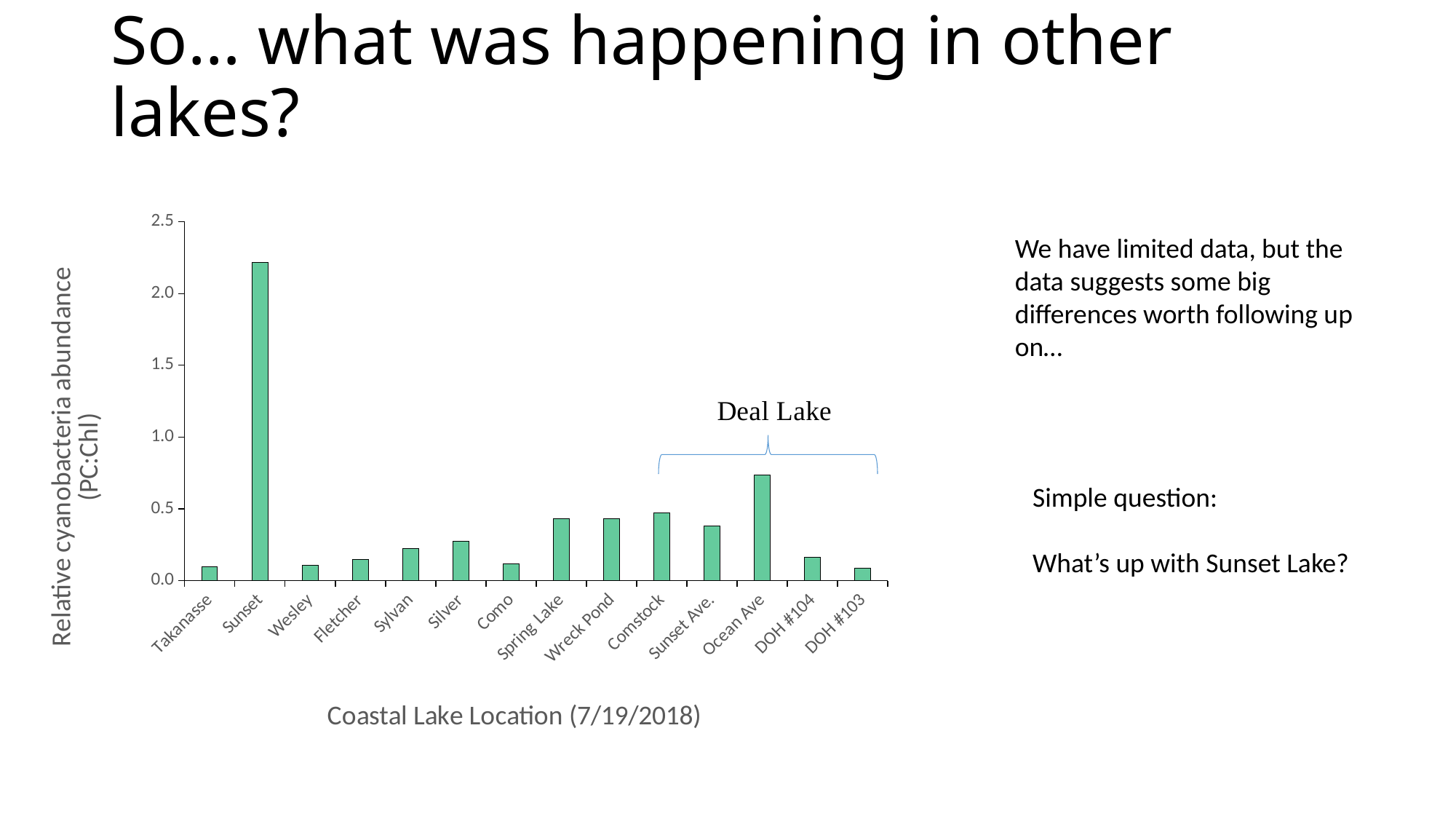
What is the x-axis title of the chart? Coastal Lake Location (7/19/2018) What kind of chart is shown on the slide? bar chart Is the value for Sunset greater or less than 2.0? greater Which has a larger value, Sylvan or Fletcher? Sylvan Which lake location has the highest relative cyanobacteria abundance? Sunset Is the value for Ocean Ave greater or less than 0.5? greater How many lake locations are plotted on the x axis? 14 Which has a larger value, Sunset or Ocean Ave? Sunset Is the value for Silver greater or less than 0.5? less Which label is shown above the bracket grouping Comstock, Sunset Ave. and Ocean Ave? Deal Lake Which has a larger value, Ocean Ave or Sunset Ave.? Ocean Ave